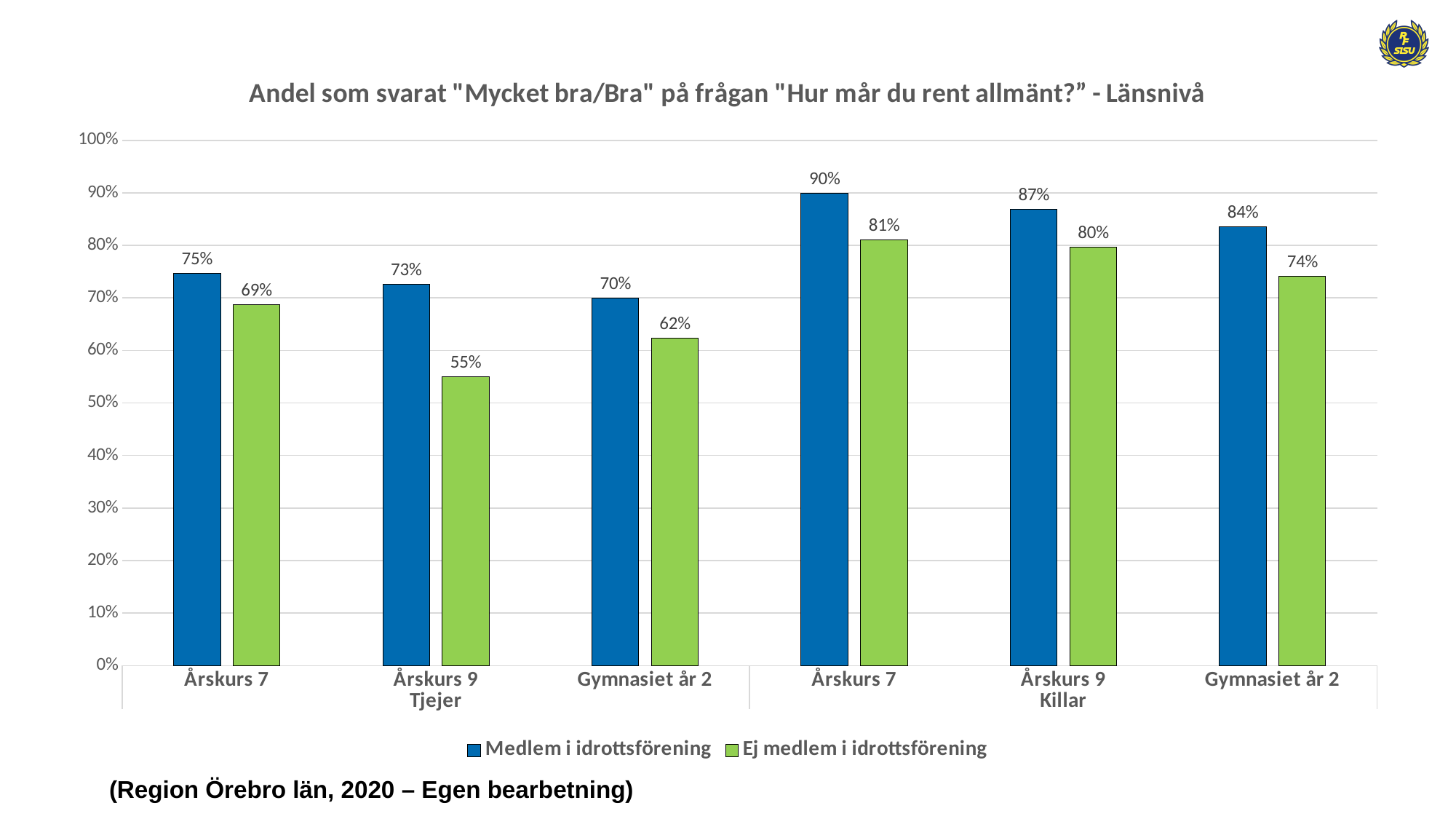
What is the difference between "Medlem i idrottsförening" and "Ej medlem i idrottsförening" for Årskurs 9 among Tjejer? 18 percentage points Which group has the highest value for "Medlem i idrottsförening"? Årskurs 7 (Killar) What colour represents "Ej medlem i idrottsförening" in the chart? Green What is the value for "Medlem i idrottsförening" for Årskurs 7 among Killar? 90% Which is larger for Gymnasiet år 2 among Killar: "Medlem i idrottsförening" or "Ej medlem i idrottsförening"? Medlem i idrottsförening Which group has the lowest value for "Ej medlem i idrottsförening"? Årskurs 9 (Tjejer) How many series does the legend list? 2 What is the value for "Medlem i idrottsförening" for Årskurs 7 among Tjejer? 75% What is the value for "Ej medlem i idrottsförening" for Gymnasiet år 2 among Killar? 74% What is the value for "Ej medlem i idrottsförening" for Årskurs 9 among Tjejer? 55% What kind of chart is shown on the slide? Bar chart Is the value for "Ej medlem i idrottsförening" for Gymnasiet år 2 among Tjejer greater or less than 70%? less